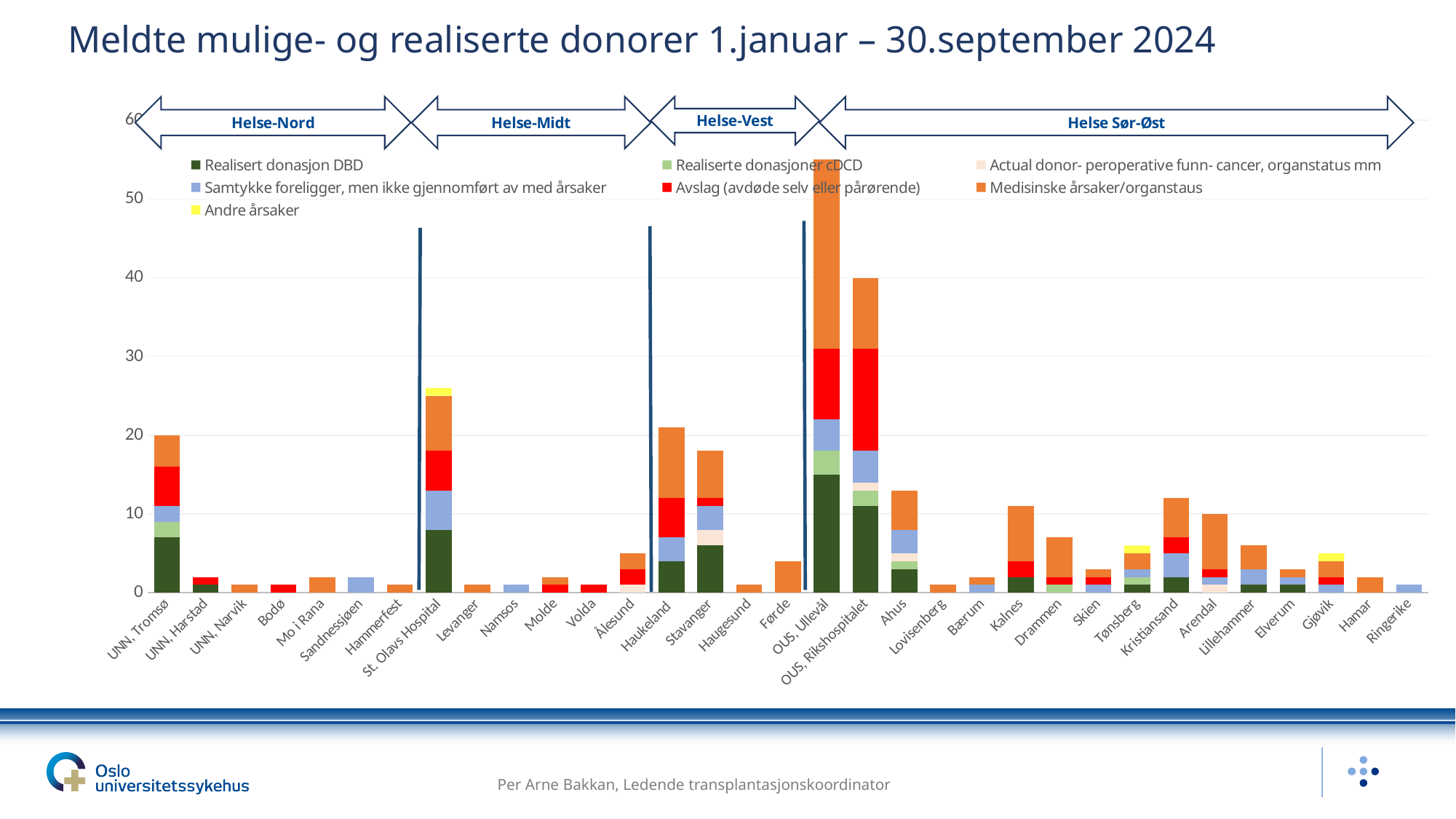
What kind of chart is shown on the slide? bar chart Is the total for St. Olavs Hospital greater or less than 20? greater Which hospital has the tallest stacked bar? OUS, Ullevål Is the total for OUS, Ullevål greater or less than 50? greater What is the title of the chart? Meldte mulige- og realiserte donorer 1.januar – 30.september 2024 Is the total for Stavanger greater or less than 20? less Which legend entry is shown in yellow? Andre årsaker How many hospitals (categories) are shown on the x axis? 33 Which has the taller stacked bar, St. Olavs Hospital or Haukeland? St. Olavs Hospital Which has the taller stacked bar, OUS, Rikshospitalet or Ahus? OUS, Rikshospitalet How many series does the legend list? 7